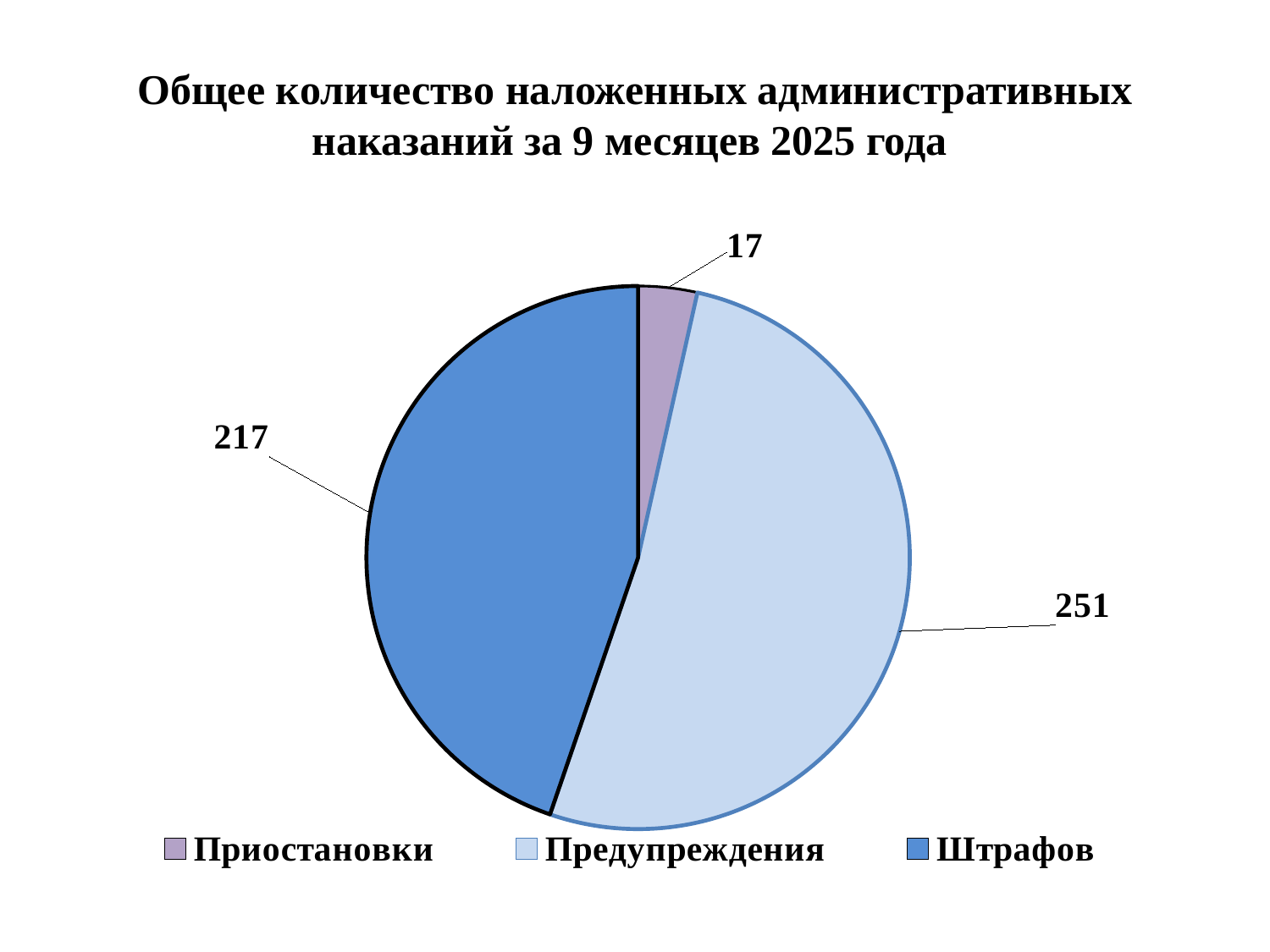
How many categories does the pie chart have? 3 What is the title of the chart? Общее количество наложенных административных наказаний за 9 месяцев 2025 года What is the total of all slices in the pie chart? 485 Which category has the smallest slice? Приостановки Which is larger, Штрафов or Предупреждения? Предупреждения What is the value for Предупреждения? 251 What is the difference between Предупреждения and Штрафов? 34 What is the value for Приостановки? 17 What type of chart is shown on the slide? pie chart Which category has the largest slice? Предупреждения What is the difference between Штрафов and Приостановки? 200 What is the value for Штрафов? 217